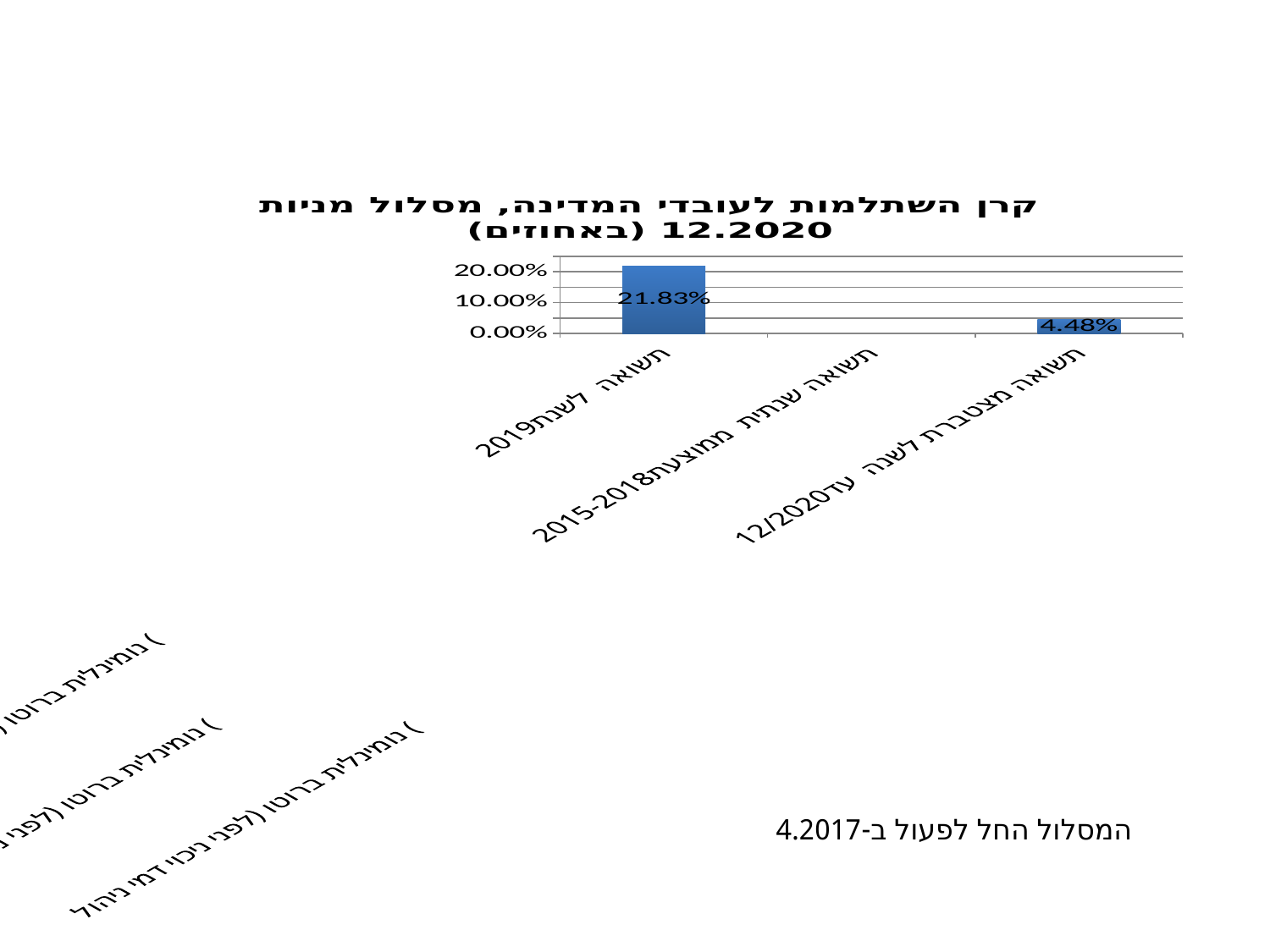
What is the highest value labelled on the y axis? 20.00% What is the value for 'תשואה מצטברת לשנה עד 12/2020'? 4.48% What type of chart is shown on the slide? bar chart What is the title of the chart? קרן השתלמות לעובדי המדינה, מסלול מניות 12.2020 (באחוזים) What is the value for 'תשואה לשנת 2019'? 21.83% Is the value for 'תשואה לשנת 2019' greater or less than 20.00%? greater Is the value for 'תשואה מצטברת לשנה עד 12/2020' greater or less than 10.00%? less How many categories are shown on the x axis? 3 Which category has the highest value? תשואה לשנת 2019 What is the difference between the value for 'תשואה לשנת 2019' and the value for 'תשואה מצטברת לשנה עד 12/2020'? 17.35% Which is larger: the value for 'תשואה לשנת 2019' or the value for 'תשואה מצטברת לשנה עד 12/2020'? תשואה לשנת 2019